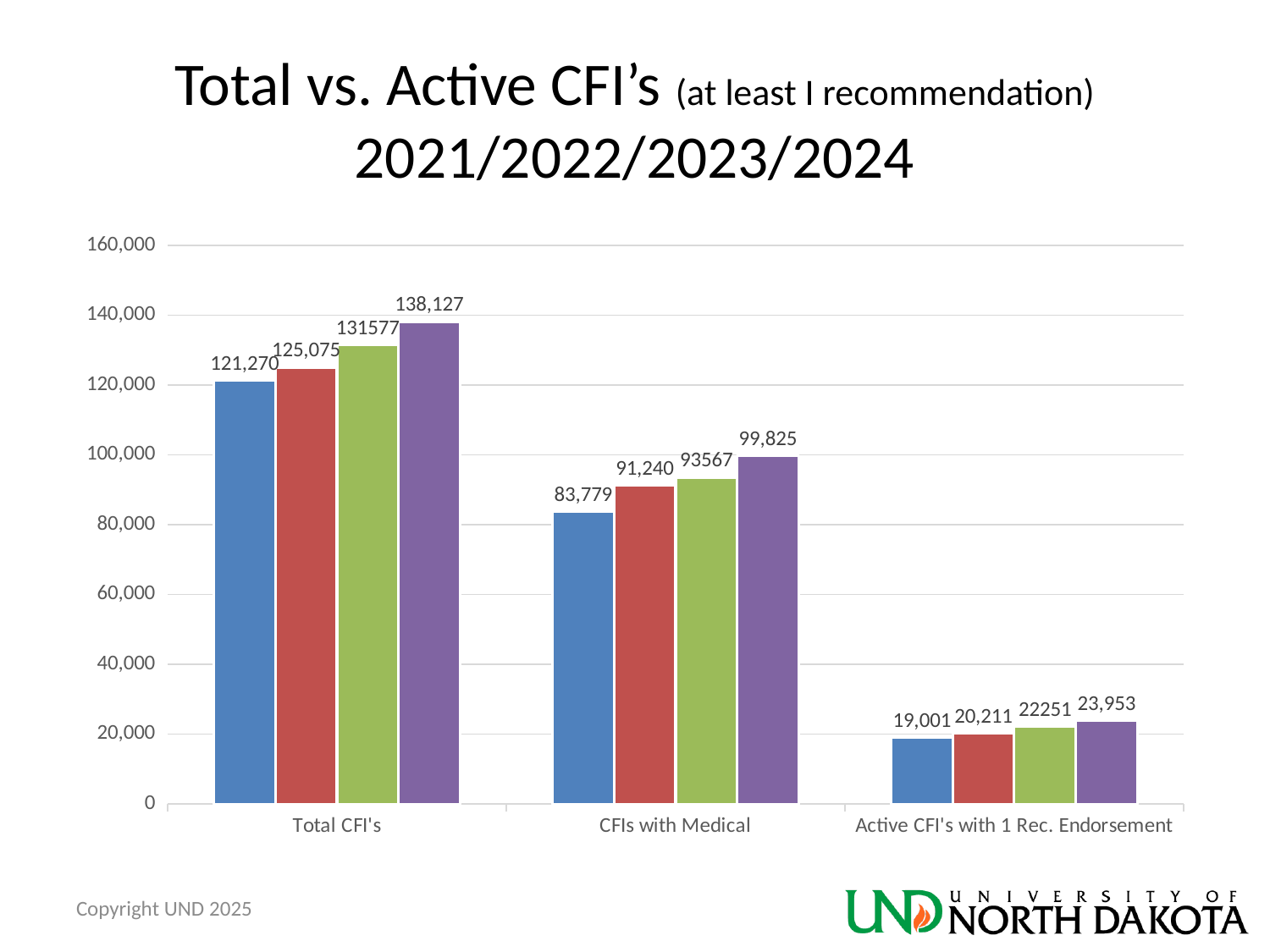
What is the value of the green (third) bar for Active CFI's with 1 Rec. Endorsement? 22251 What is the difference between the purple (fourth) bar and the blue (first) bar for Total CFI's? 16,857 How many categories are shown on the x axis? 3 Within each category, do the bars rise or fall from left to right? Rise What is the value of the blue (first) bar for Total CFI's? 121,270 What kind of chart is shown on the slide? Bar chart Which category has the highest bars on the chart? Total CFI's What is the value of the purple (fourth) bar for CFIs with Medical? 99,825 How many bars are shown for each category? 4 What is the value of the lowest bar on the chart? 19,001 Which is larger: the red bar for Total CFI's or the purple bar for CFIs with Medical? The red bar for Total CFI's What is the difference between the red (second) bar and the blue (first) bar for CFIs with Medical? 7,461